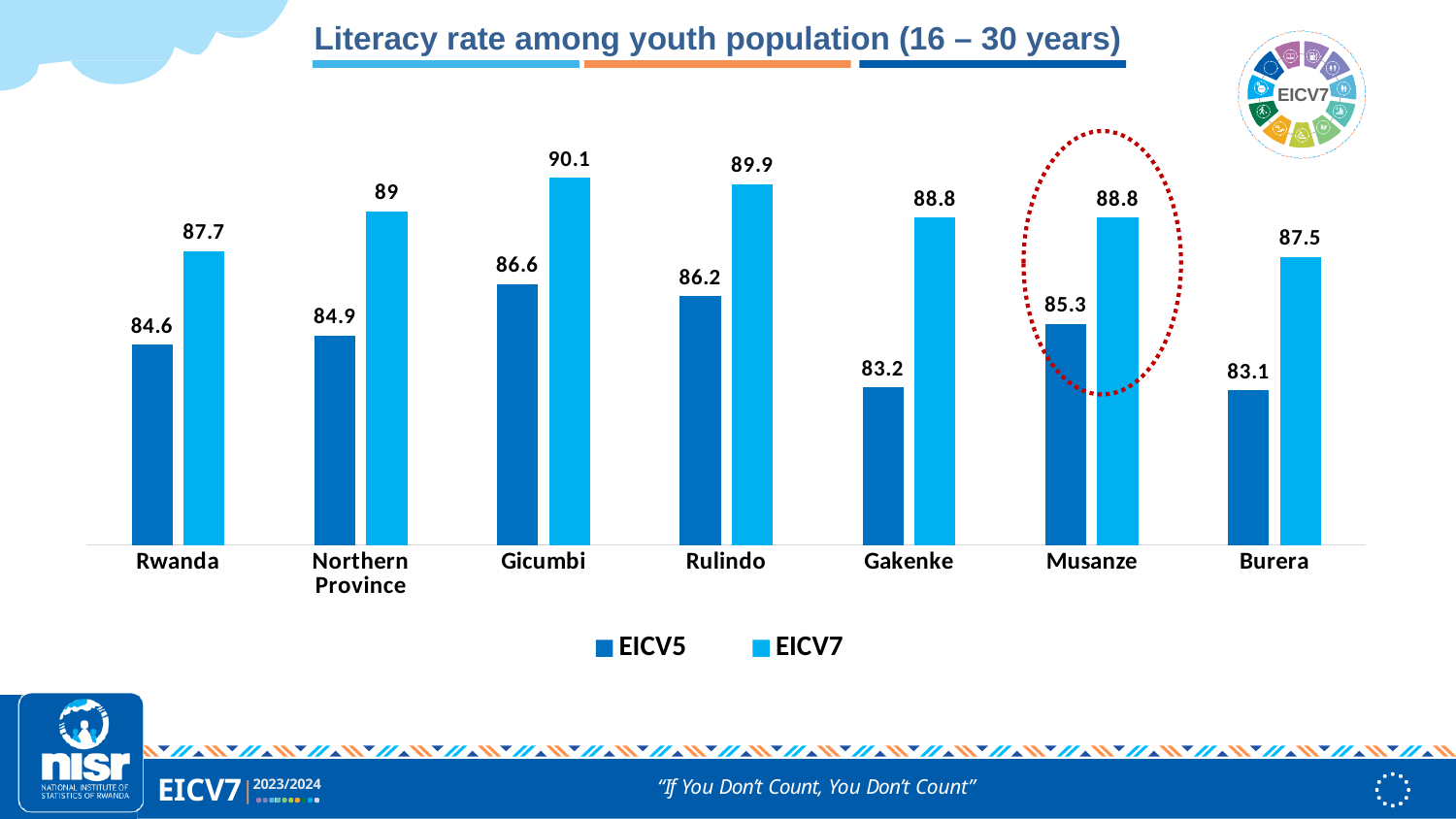
Which is larger, the EICV5 value for Gicumbi or the EICV5 value for Rulindo? Gicumbi What is the EICV7 literacy rate for Gicumbi? 90.1 Which category has the lowest EICV5 value? Burera What is the difference between the EICV7 and EICV5 values for Gakenke? 5.6 How many series does the legend list? 2 What kind of chart is shown on the slide? Bar chart Which category has the highest EICV7 value? Gicumbi How many categories are shown on the x axis? 7 What is the difference between the EICV7 and EICV5 values for Musanze? 3.5 What is the EICV5 literacy rate for Rwanda? 84.6 What is the title of the chart? Literacy rate among youth population (16 – 30 years) What is the EICV5 literacy rate for Musanze? 85.3